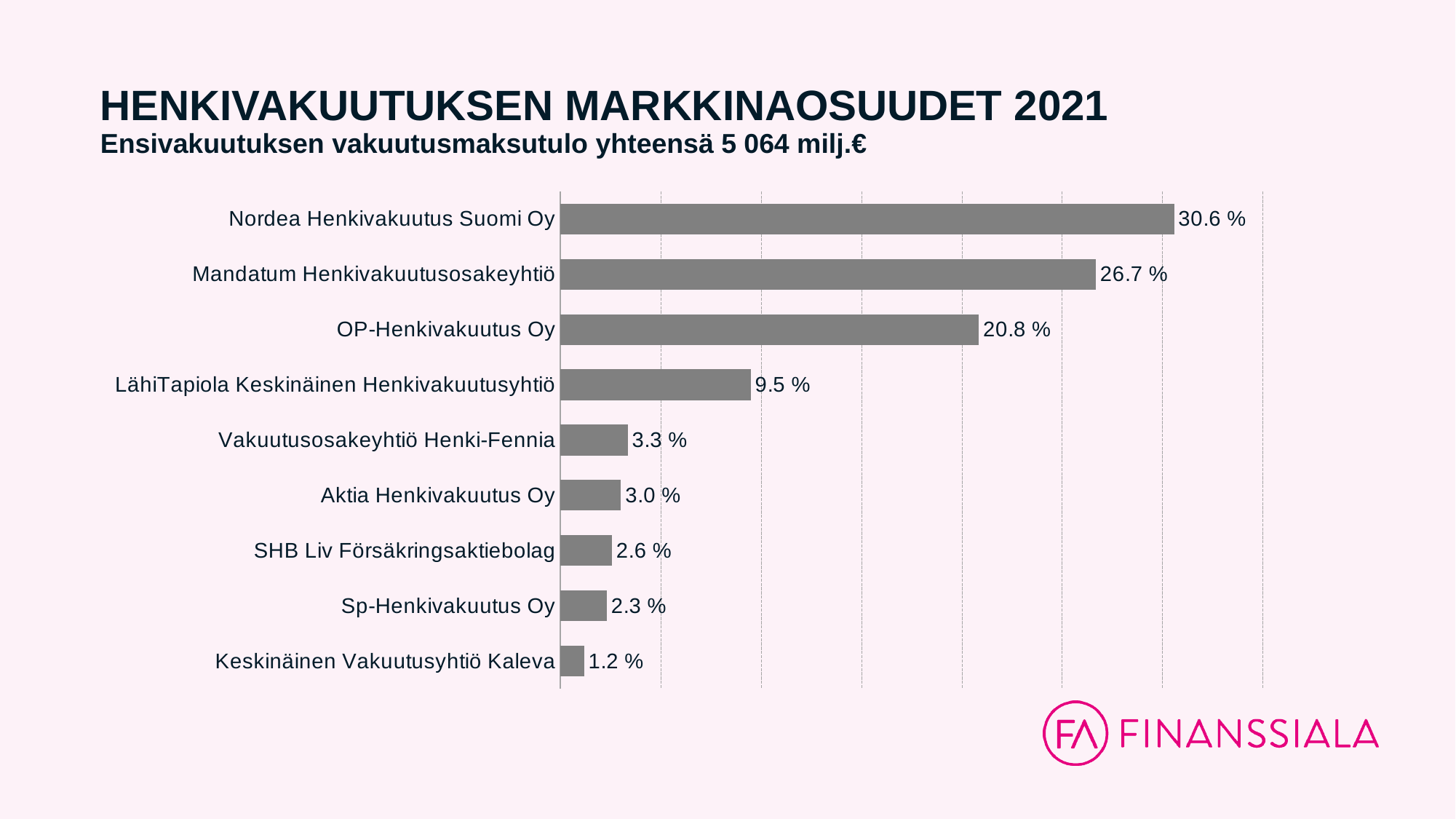
What is the market share of Nordea Henkivakuutus Suomi Oy? 30.6 % What is the title of the slide? HENKIVAKUUTUKSEN MARKKINAOSUUDET 2021 What is the difference in market share between Nordea Henkivakuutus Suomi Oy and Mandatum Henkivakuutusosakeyhtiö? 3.9 % What is the market share of Sp-Henkivakuutus Oy? 2.3 % Which company has the highest market share? Nordea Henkivakuutus Suomi Oy What kind of chart is shown on the slide? Bar chart What is the total premium income stated in the subtitle? 5 064 milj.€ What is the market share of OP-Henkivakuutus Oy? 20.8 % How many companies are shown in the chart? 9 Which has a larger market share, Vakuutusosakeyhtiö Henki-Fennia or Aktia Henkivakuutus Oy? Vakuutusosakeyhtiö Henki-Fennia Which company has the lowest market share? Keskinäinen Vakuutusyhtiö Kaleva What is the market share of LähiTapiola Keskinäinen Henkivakuutusyhtiö? 9.5 %